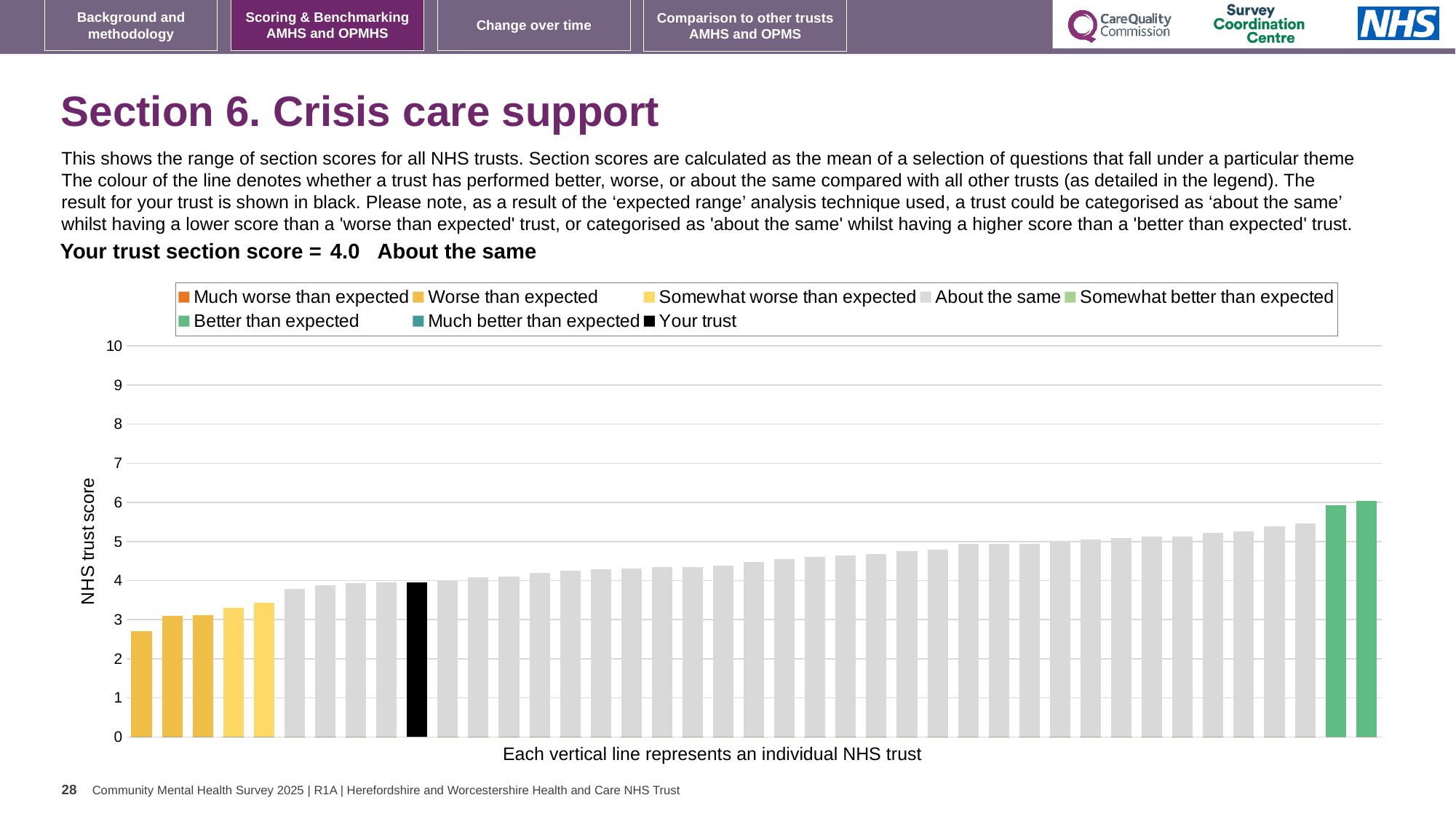
What is the label on the vertical axis of the chart? NHS trust score Which category is your trust placed in for this section? About the same Is the value of the lowest bar greater or less than 3? less Which is higher, the leftmost bar or the rightmost bar? rightmost Is the value of the highest bar greater or less than 7? less How many entries does the chart legend list? 8 How many bars are coloured green (better than expected)? 2 What kind of chart is shown on the slide? bar chart What is the section score for your trust shown on the slide? 4.0 Do the bar values rise or fall from left to right along the x axis? rise What colour is the bar representing your trust? black Is the value of the highest bar greater or less than 5? greater